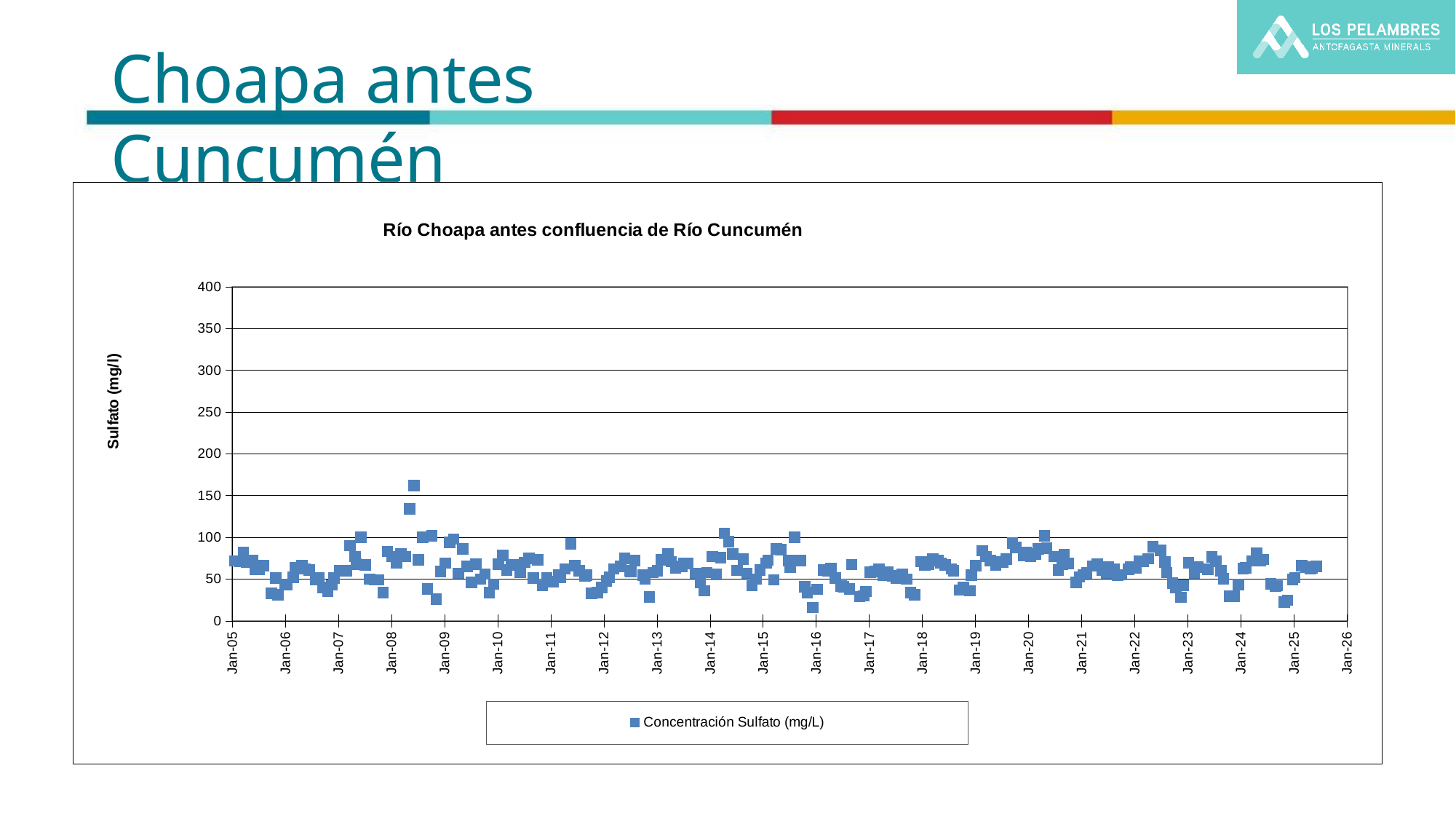
What is the name of the series shown in the legend? Concentración Sulfato (mg/L) What is the highest value shown on the y axis? 400 Do the sulfate values show a strong rising or falling trend from Jan-05 to Jan-25, or do they stay roughly level? roughly level What is the title of the chart? Río Choapa antes confluencia de Río Cuncumén Is the lowest plotted sulfate value greater or less than 50? less What kind of chart is shown on the slide? scatter chart Is the highest plotted sulfate value greater or less than 200? less How many series does the chart legend list? 1 How many year labels are shown on the x axis? 22 Is the highest plotted sulfate value greater or less than 150? greater Around which year does the highest sulfate concentration point occur? 2008